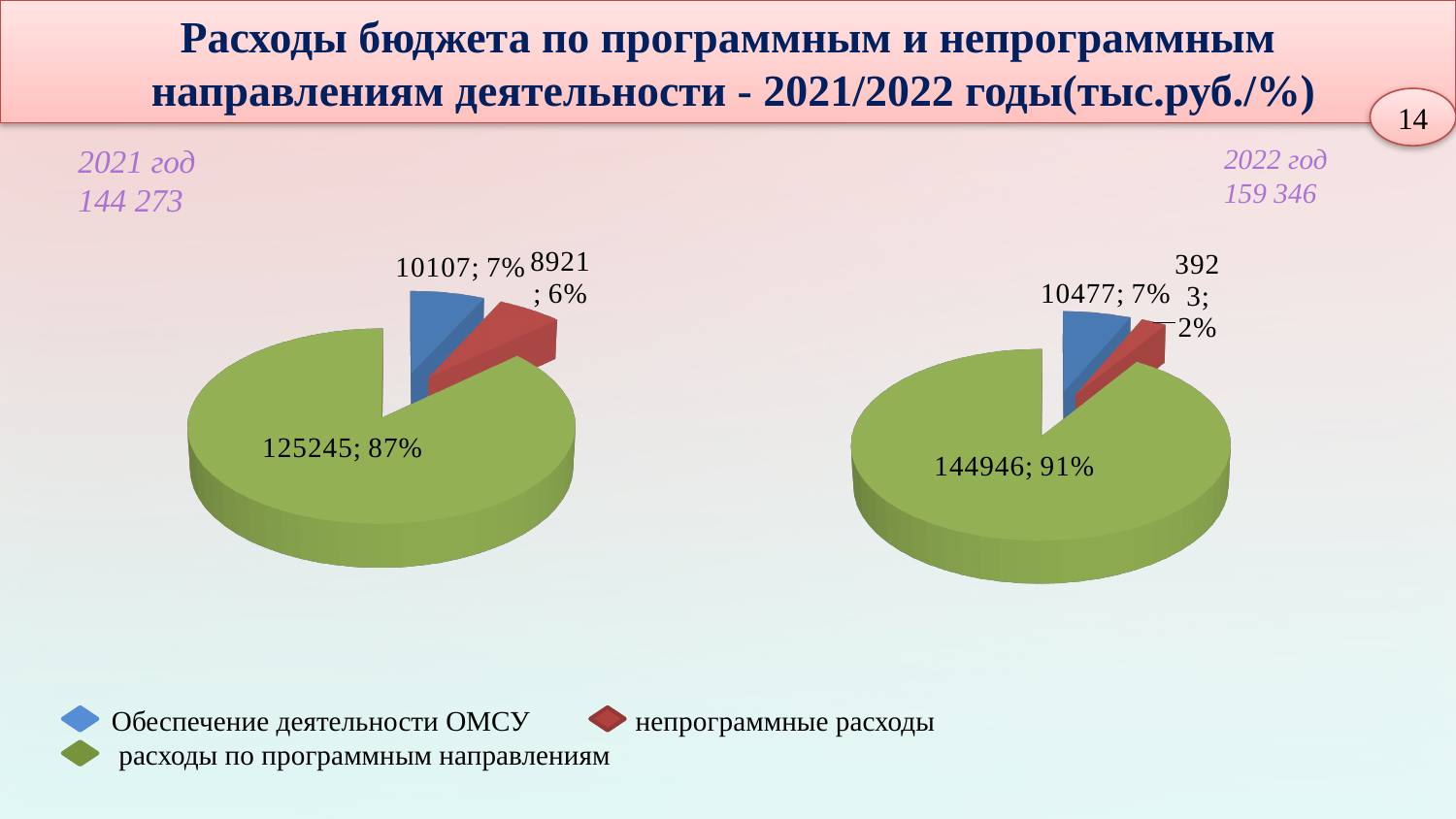
In the 2022 год pie chart, what is the value for Обеспечение деятельности ОМСУ? 10477; 7% Which colour represents непрограммные расходы in the legend? Red What kind of charts are shown on the slide? Pie charts In the 2022 год pie chart, which category has the smallest slice? непрограммные расходы In the 2021 год pie chart, what is the difference between Обеспечение деятельности ОМСУ and непрограммные расходы? 1186 How many categories does the legend list? 3 In the 2021 год pie chart, what is the value for непрограммные расходы? 8921; 6% In the 2022 год pie chart, what is the value for расходы по программным направлениям? 144946; 91% In the 2022 год pie chart, what share of the pie does непрограммные расходы take? 2% In the 2021 год pie chart, what is the value for расходы по программным направлениям? 125245; 87% In the 2021 год pie chart, which category has the largest slice? расходы по программным направлениям In the 2021 год pie chart, what is the value for Обеспечение деятельности ОМСУ? 10107; 7%